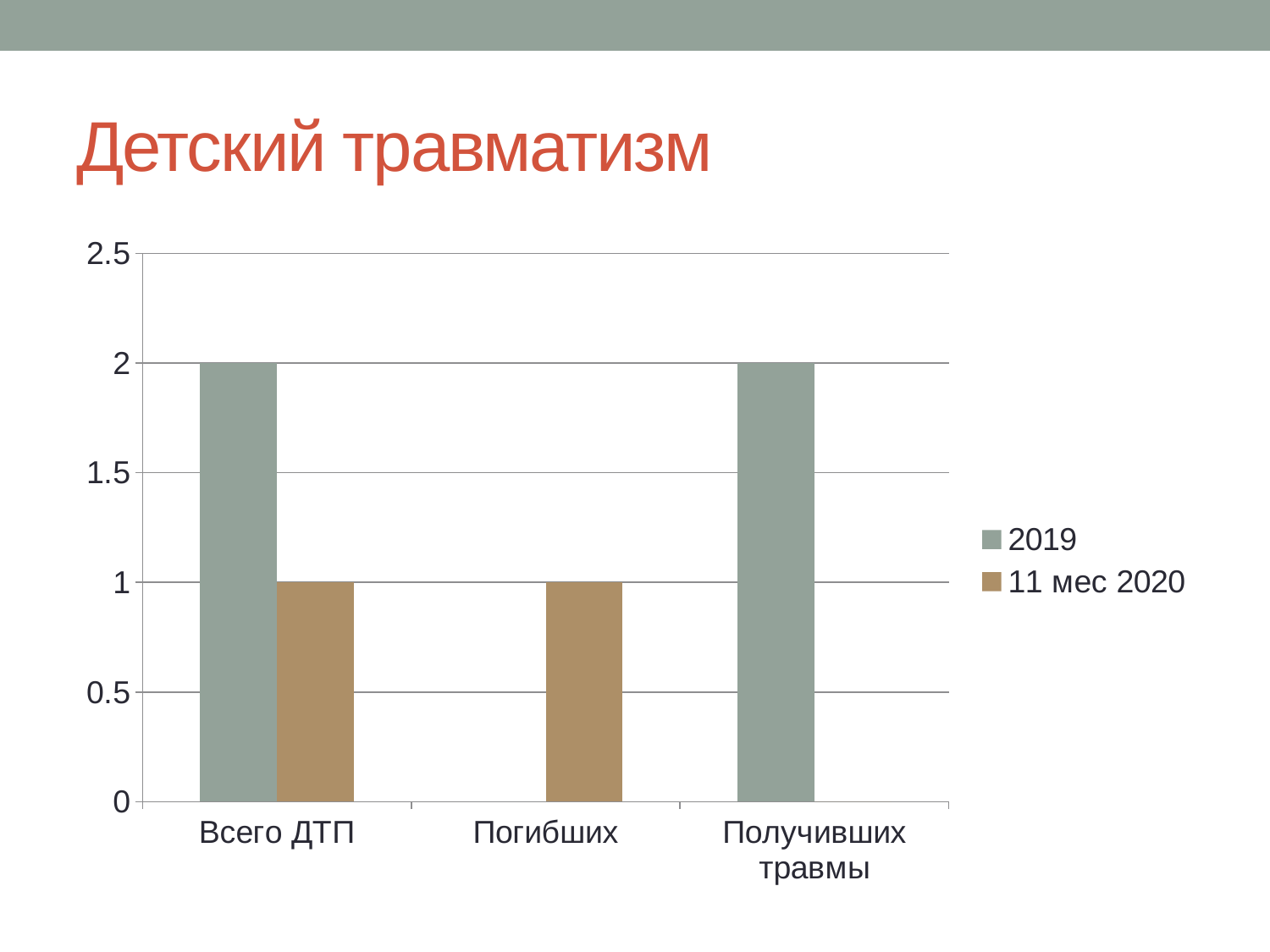
What is the title of the slide? Детский травматизм Which category has the lowest value in the 2019 series? Погибших How many categories are shown on the x axis? 3 What kind of chart is shown on the slide? bar chart What is the value for Всего ДТП in the 2019 series? 2 What is the value for Получивших травмы in the 2019 series? 2 How many series does the legend list? 2 What is the value for Погибших in the 11 мес 2020 series? 1 Is the value for Получивших травмы in the 2019 series greater or less than 1.5? greater What is the difference between the 2019 and 11 мес 2020 values for Всего ДТП? 1 What is the value for Всего ДТП in the 11 мес 2020 series? 1 Which is larger for Всего ДТП: the 2019 value or the 11 мес 2020 value? 2019